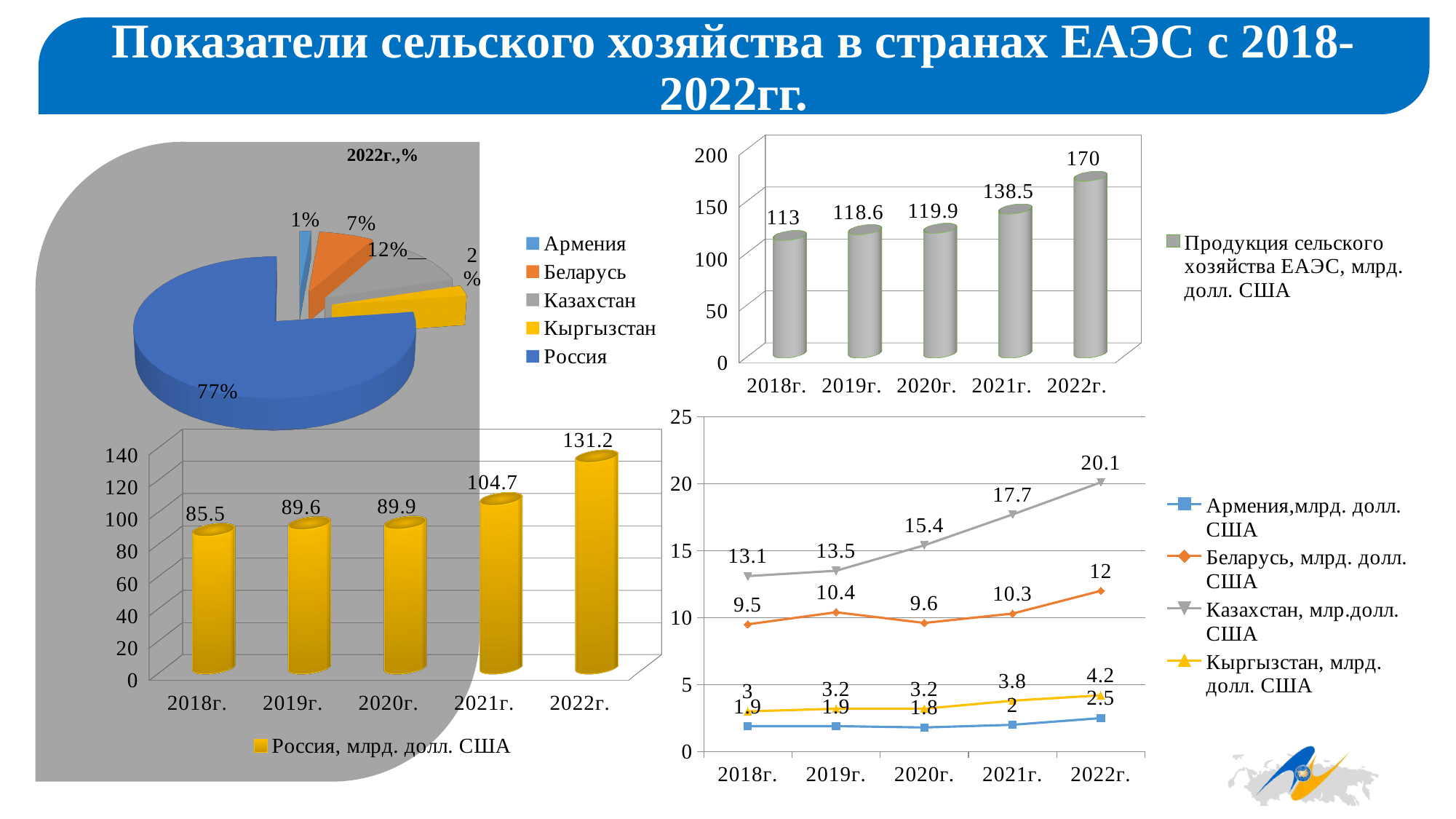
In the bottom-left bar chart (Россия, млрд. долл. США), which year has the highest value? 2022г. In the pie chart titled "2022г.,%", what share does Россия have? 77% In the top-right bar chart (Продукция сельского хозяйства ЕАЭС), what is the difference between the 2022г. and 2021г. values? 31.5 In the bottom-right line chart, what is the value for Казахстан in 2020г.? 15.4 In the top-right bar chart (Продукция сельского хозяйства ЕАЭС), do the values rise or fall from 2018г. to 2022г.? rise In the top-right bar chart (Продукция сельского хозяйства ЕАЭС), what is the value for 2022г.? 170 In the pie chart titled "2022г.,%", which country has the smallest slice? Армения In the bottom-left bar chart (Россия, млрд. долл. США), what kind of chart is it? bar chart In the bottom-left bar chart (Россия, млрд. долл. США), what is the value for 2019г.? 89.6 In the bottom-right line chart, how many series does the legend list? 4 In the bottom-right line chart, which is larger in 2022г.: Беларусь or Кыргызстан? Беларусь In the pie chart titled "2022г.,%", how many countries are shown in the legend? 5